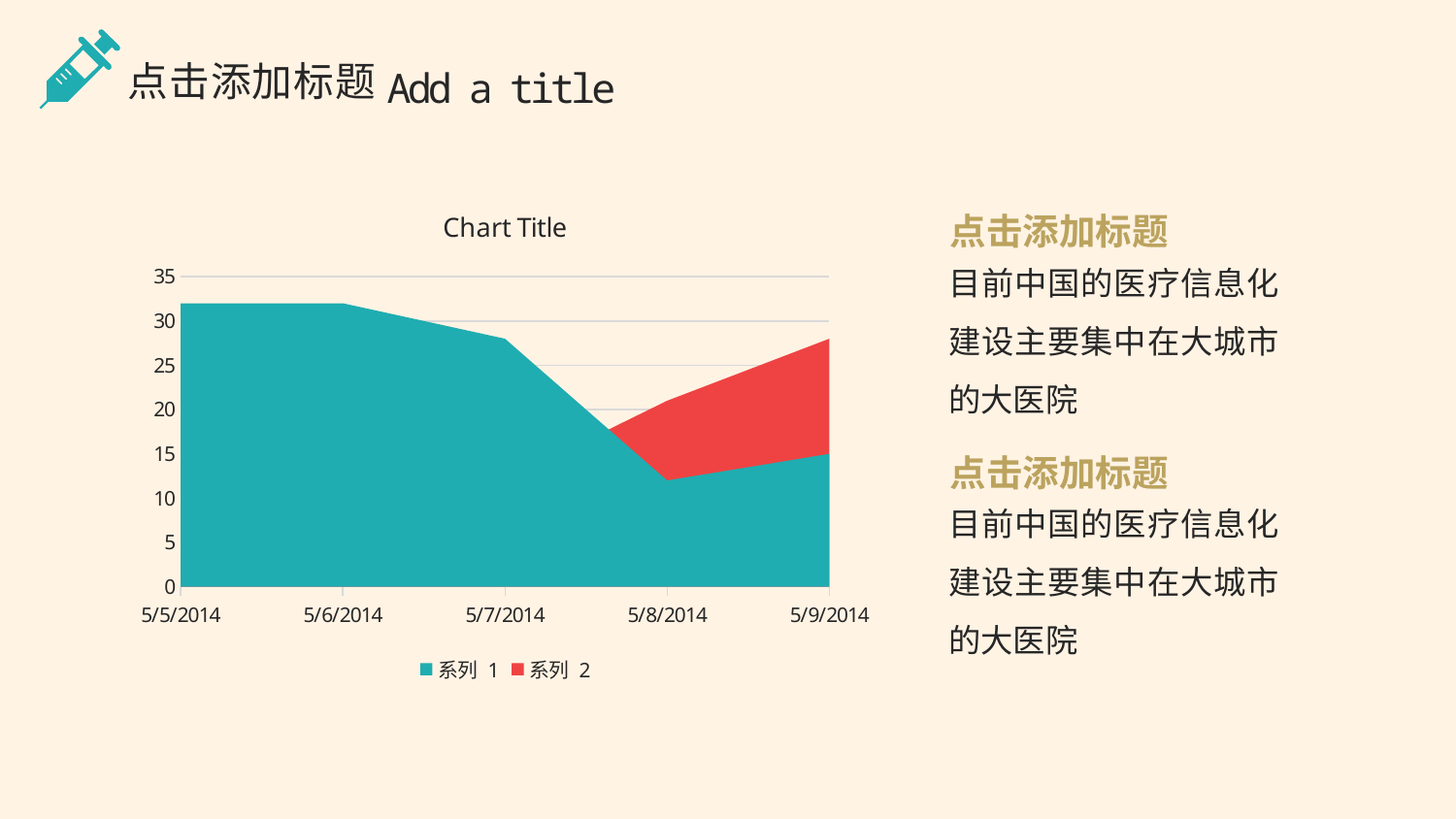
Is the value for 系列 1 on 5/8/2014 greater or less than 15? less How many series does the chart legend list? 2 Does the value for 系列 1 rise or fall from 5/5/2014 to 5/8/2014? Fall What kind of chart is shown on the slide? Area chart Which is larger for 系列 1: the value on 5/7/2014 or on 5/8/2014? 5/7/2014 What colour represents 系列 1 in the chart? Teal On which date is the value for 系列 1 lowest? 5/8/2014 What is the title of the chart? Chart Title Is the value for 系列 2 on 5/9/2014 greater or less than 25? greater Is the value for 系列 1 on 5/5/2014 greater or less than 30? greater How many dates are shown on the x axis of the chart? 5